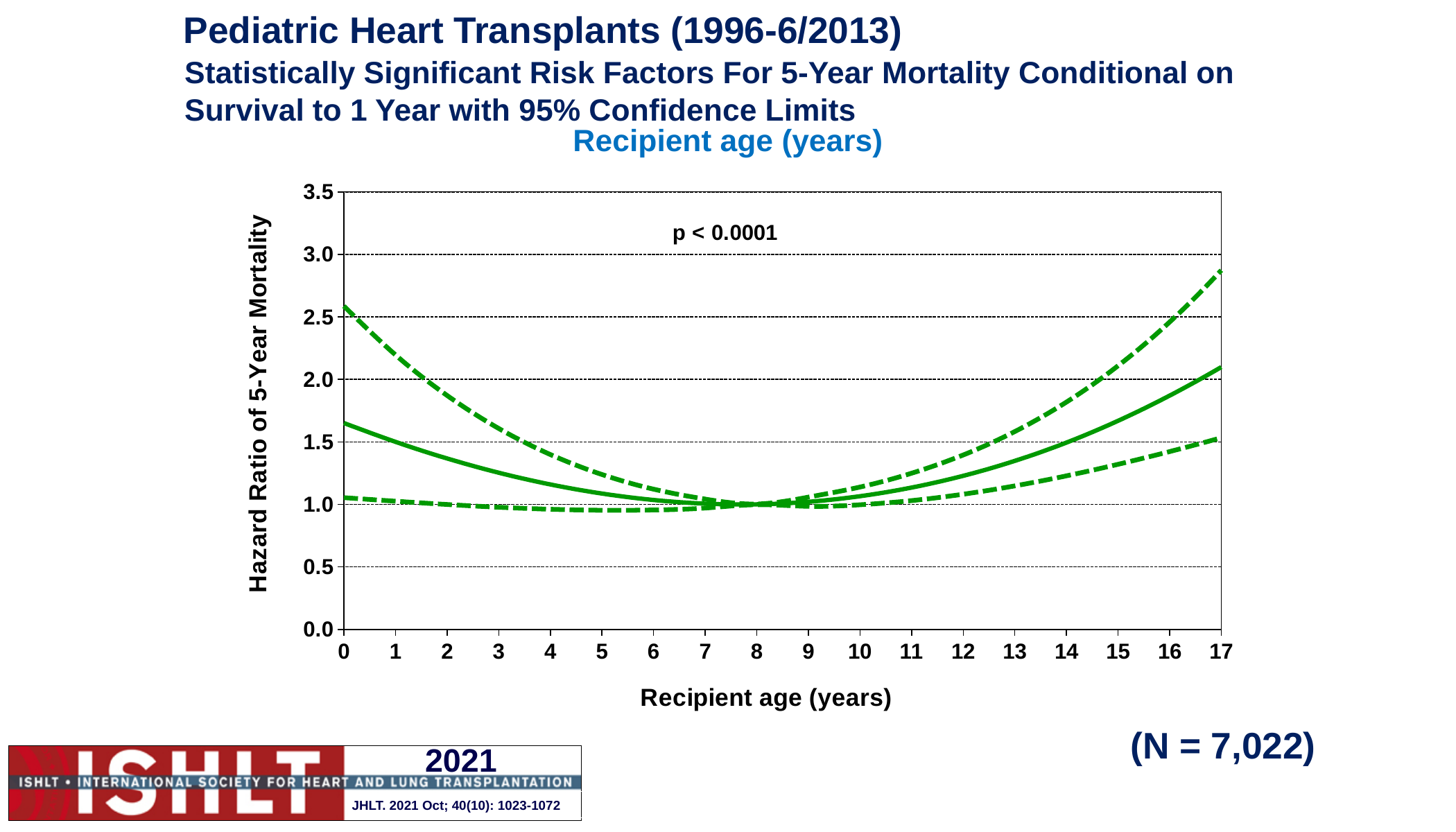
Which has the higher hazard ratio on the solid line: recipient age 0 or recipient age 17? recipient age 17 What p-value is printed on the chart? p < 0.0001 Is the upper dashed confidence limit at recipient age 0 greater or less than 2.0? greater Does the solid hazard ratio line rise or fall between recipient age 0 and age 8? fall How many lines are plotted on the chart? 3 Is the upper dashed confidence limit at recipient age 17 greater or less than 3.0? less What is the hazard ratio of the solid line at recipient age 8 years? 1.0 What kind of chart is shown on the slide? line chart Is the hazard ratio of the solid line at recipient age 0 greater or less than 1.5? greater What is the label of the y axis? Hazard Ratio of 5-Year Mortality Does the solid hazard ratio line rise or fall between recipient age 8 and age 17? rise